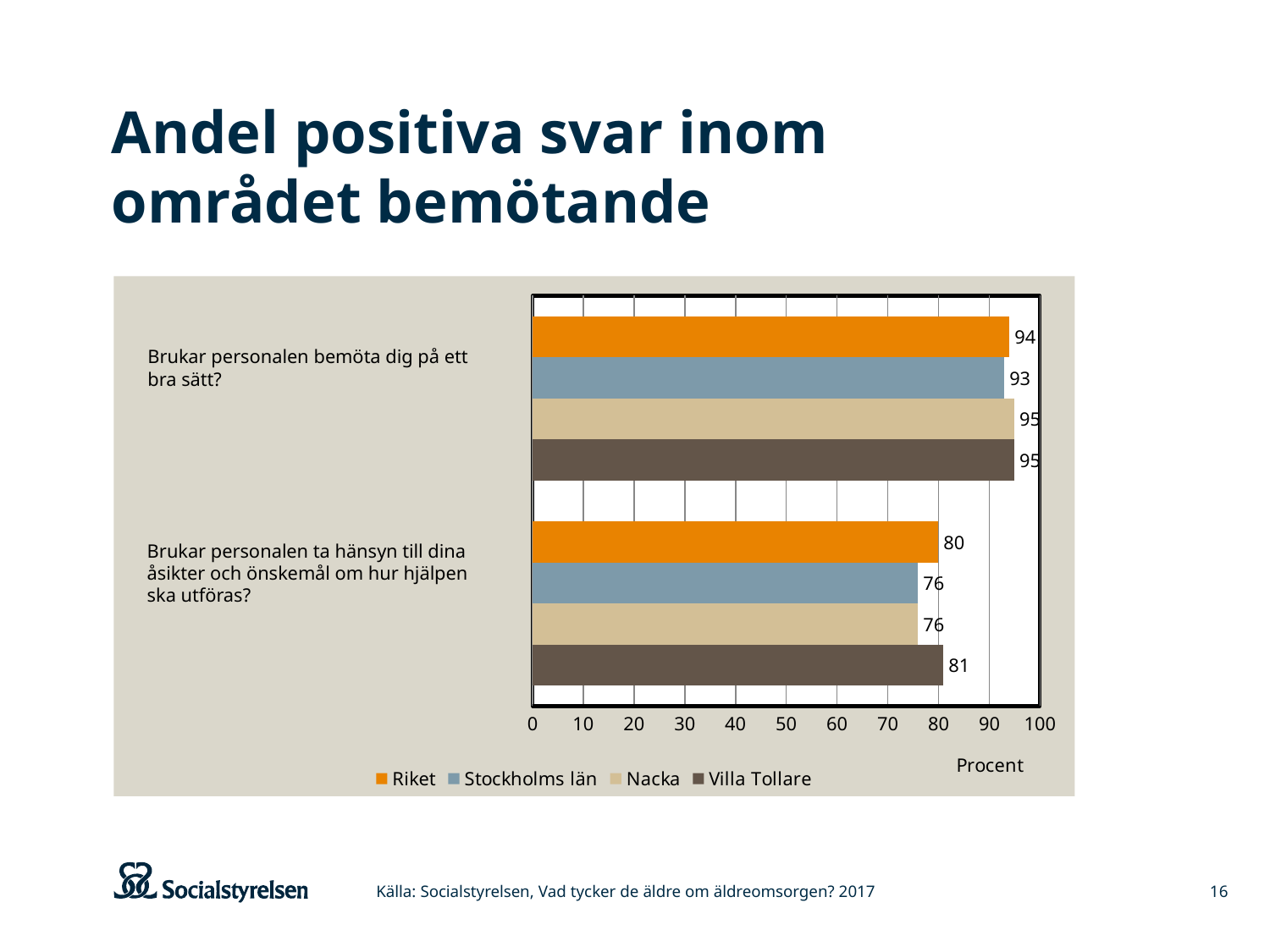
Which series has the highest value for the question "Brukar personalen ta hänsyn till dina åsikter och önskemål om hur hjälpen ska utföras?"? Villa Tollare What unit is shown on the horizontal axis of the chart? Procent What is the value for Nacka for the question "Brukar personalen bemöta dig på ett bra sätt?"? 95 What is the value for Riket for the question "Brukar personalen bemöta dig på ett bra sätt?"? 94 What is the difference between the Riket values for the two questions? 14 What is the value for Villa Tollare for the question "Brukar personalen ta hänsyn till dina åsikter och önskemål om hur hjälpen ska utföras?"? 81 How many series does the legend list? 4 What kind of chart is shown on the slide? Bar chart How many questions (categories) are shown on the chart? 2 What is the value for Stockholms län for the question "Brukar personalen ta hänsyn till dina åsikter och önskemål om hur hjälpen ska utföras?"? 76 For the question "Brukar personalen ta hänsyn till dina åsikter och önskemål om hur hjälpen ska utföras?", which is larger: Riket or Stockholms län? Riket Which series has the lowest value for the question "Brukar personalen bemöta dig på ett bra sätt?"? Stockholms län